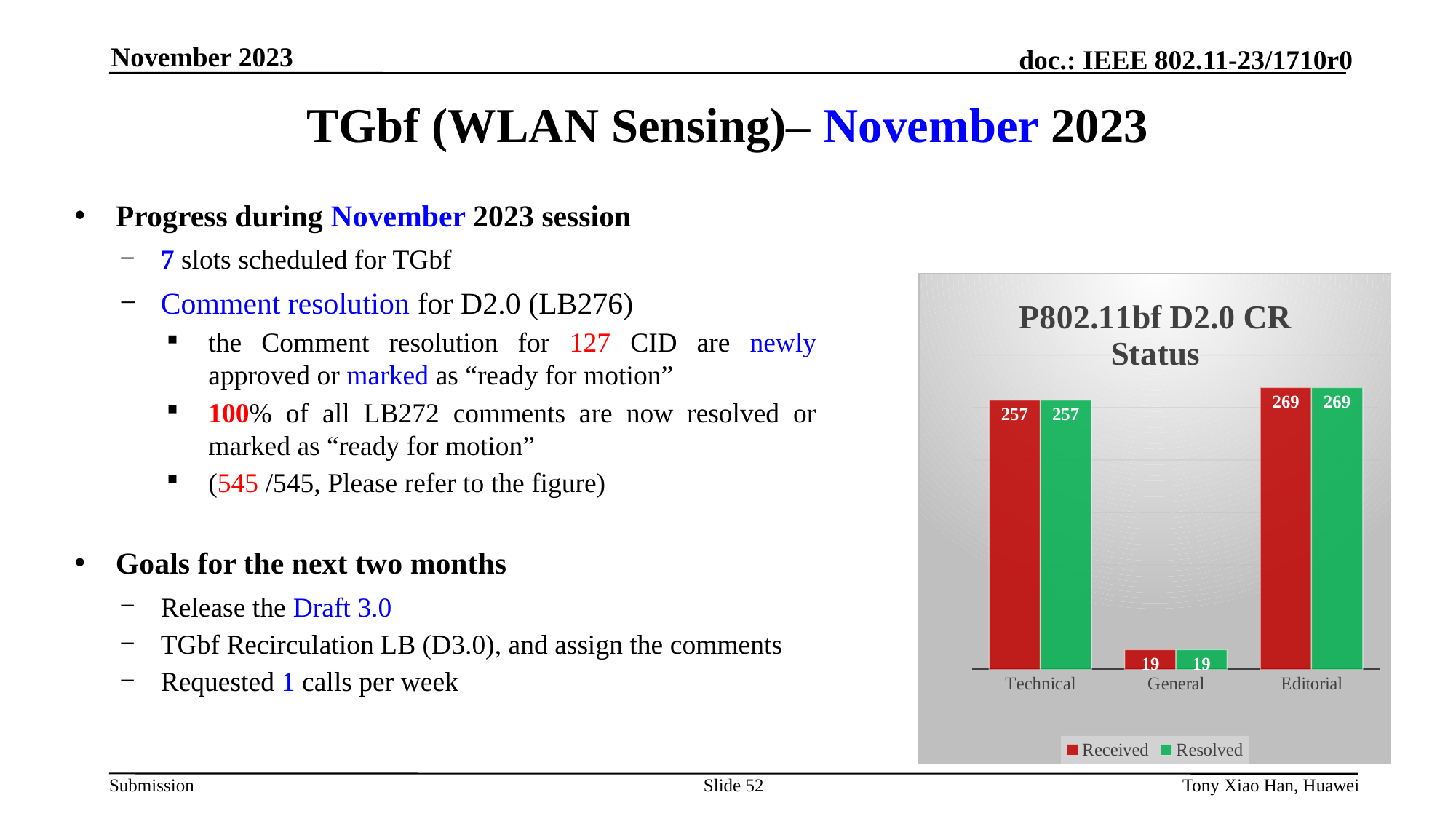
Which category has the lowest Resolved value? General What is the Received value for Editorial? 269 What is the Resolved value for General? 19 What is the difference between the Received values for Editorial and Technical? 12 What is the title of the chart? P802.11bf D2.0 CR Status Is the Received value for Technical larger or smaller than the Received value for General? larger How many series does the legend list? 2 How many categories are shown on the x axis of the chart? 3 What type of chart is shown on the slide? bar chart Which category has the highest Received value? Editorial Which series is shown in red in the legend? Received What is the Received value for Technical? 257